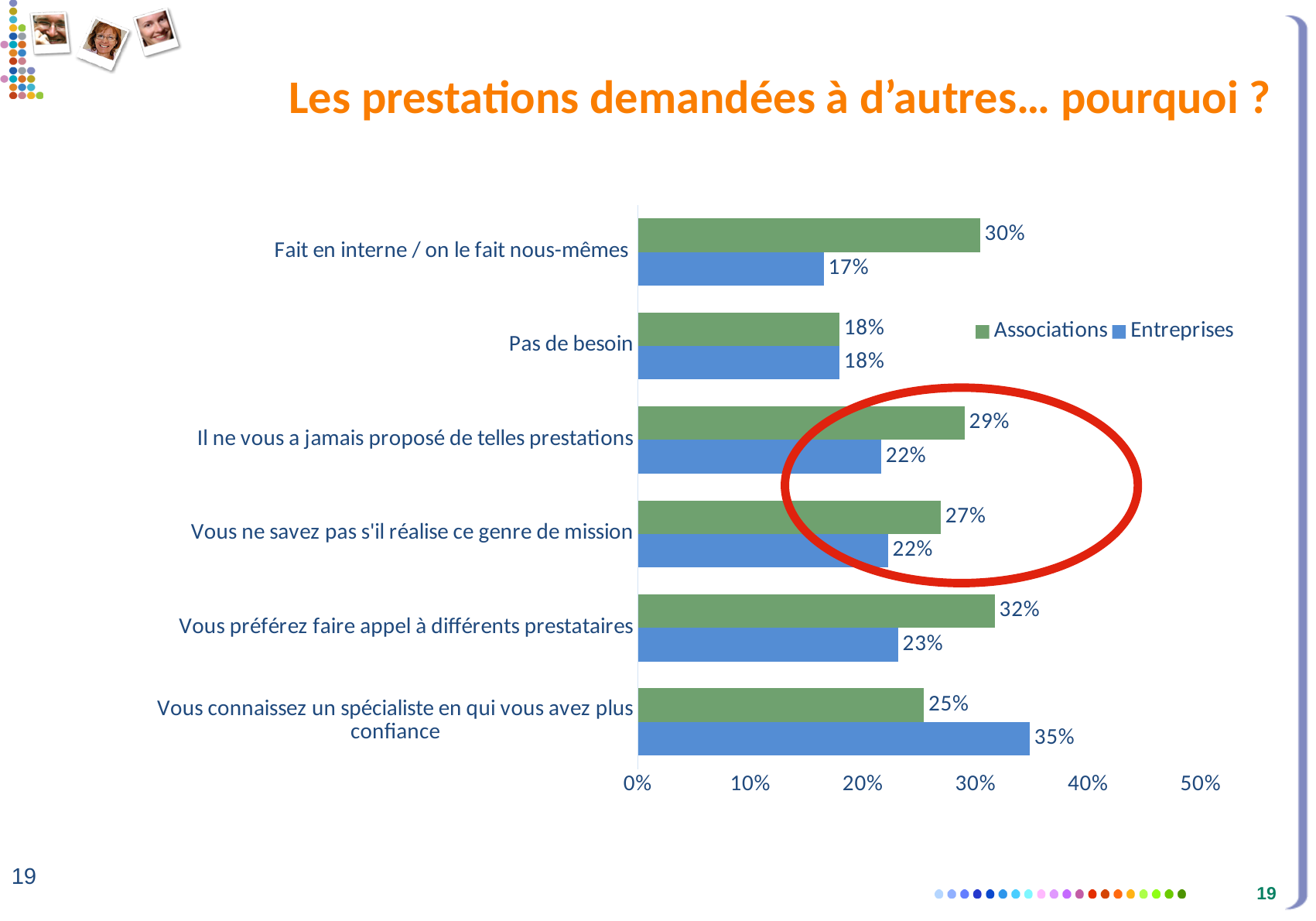
What type of chart is shown on the slide? Bar chart For "Vous connaissez un spécialiste en qui vous avez plus confiance", which series has the larger value, Associations or Entreprises? Entreprises What is the Associations value for "Fait en interne / on le fait nous-mêmes"? 30% How many categories are shown on the chart? 6 What is the Entreprises value for "Il ne vous a jamais proposé de telles prestations"? 22% What is the Entreprises value for "Vous connaissez un spécialiste en qui vous avez plus confiance"? 35% Is the Associations value for "Vous préférez faire appel à différents prestataires" greater or less than 30%? greater What is the difference between the Associations and Entreprises values for "Fait en interne / on le fait nous-mêmes"? 13% How many series does the legend list? 2 Which category has the highest Associations value? Vous préférez faire appel à différents prestataires Which colour represents the Associations series? Green Which category has the lowest Entreprises value? Fait en interne / on le fait nous-mêmes